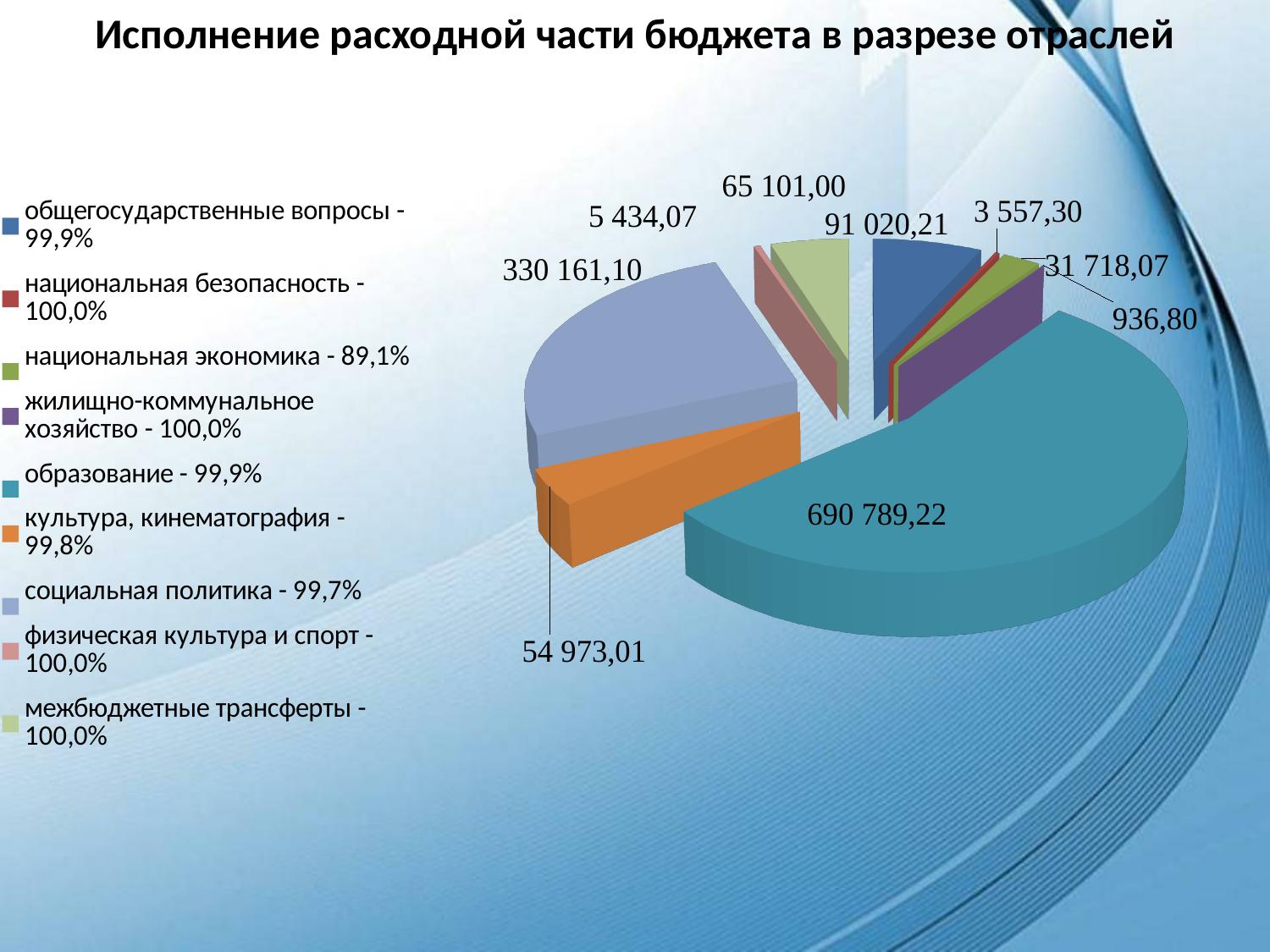
How many categories does the pie chart have? 9 How many entries does the legend list? 9 What is the value shown for образование? 690 789,22 What is the difference between the values for образование and социальная политика? 360 628,12 What is the value shown for культура, кинематография? 54 973,01 Which is larger, образование or социальная политика? образование What is the value shown for социальная политика? 330 161,10 What kind of chart is shown on the slide? pie chart What execution percentage does the legend give for национальная экономика? 89,1% Which category has the largest slice of the pie? образование What is the value shown for межбюджетные трансферты? 65 101,00 What is the value shown for общегосударственные вопросы? 91 020,21